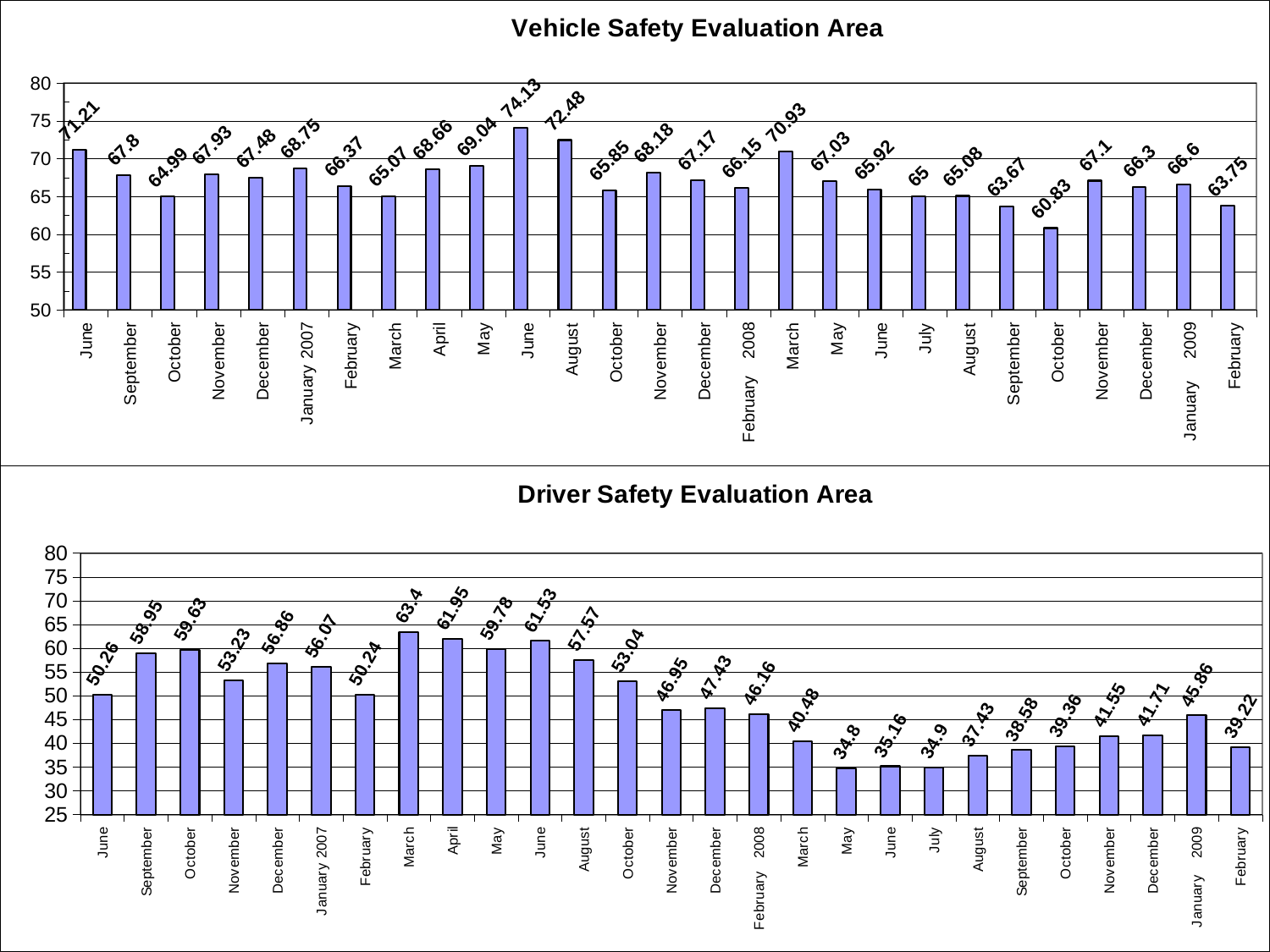
In the Driver Safety Evaluation Area chart, what is the lowest value shown? 34.8 In the Vehicle Safety Evaluation Area chart, what is the value for April? 68.66 In the Driver Safety Evaluation Area chart, what is the value for February 2008? 46.16 In the Vehicle Safety Evaluation Area chart, what is the lowest value shown? 60.83 In the Vehicle Safety Evaluation Area chart, is the value for January 2009 greater or less than 65? greater How many bars are plotted in the Driver Safety Evaluation Area chart? 27 In the Driver Safety Evaluation Area chart, what is the value for January 2009? 45.86 In the Vehicle Safety Evaluation Area chart, what is the value for January 2007? 68.75 In the Driver Safety Evaluation Area chart, what is the highest value shown? 63.4 In the Vehicle Safety Evaluation Area chart, what is the difference between the April value and the July value? 3.66 In the Vehicle Safety Evaluation Area chart, what is the highest value shown? 74.13 In the Driver Safety Evaluation Area chart, which is larger, the value for April or the value for January 2007? April